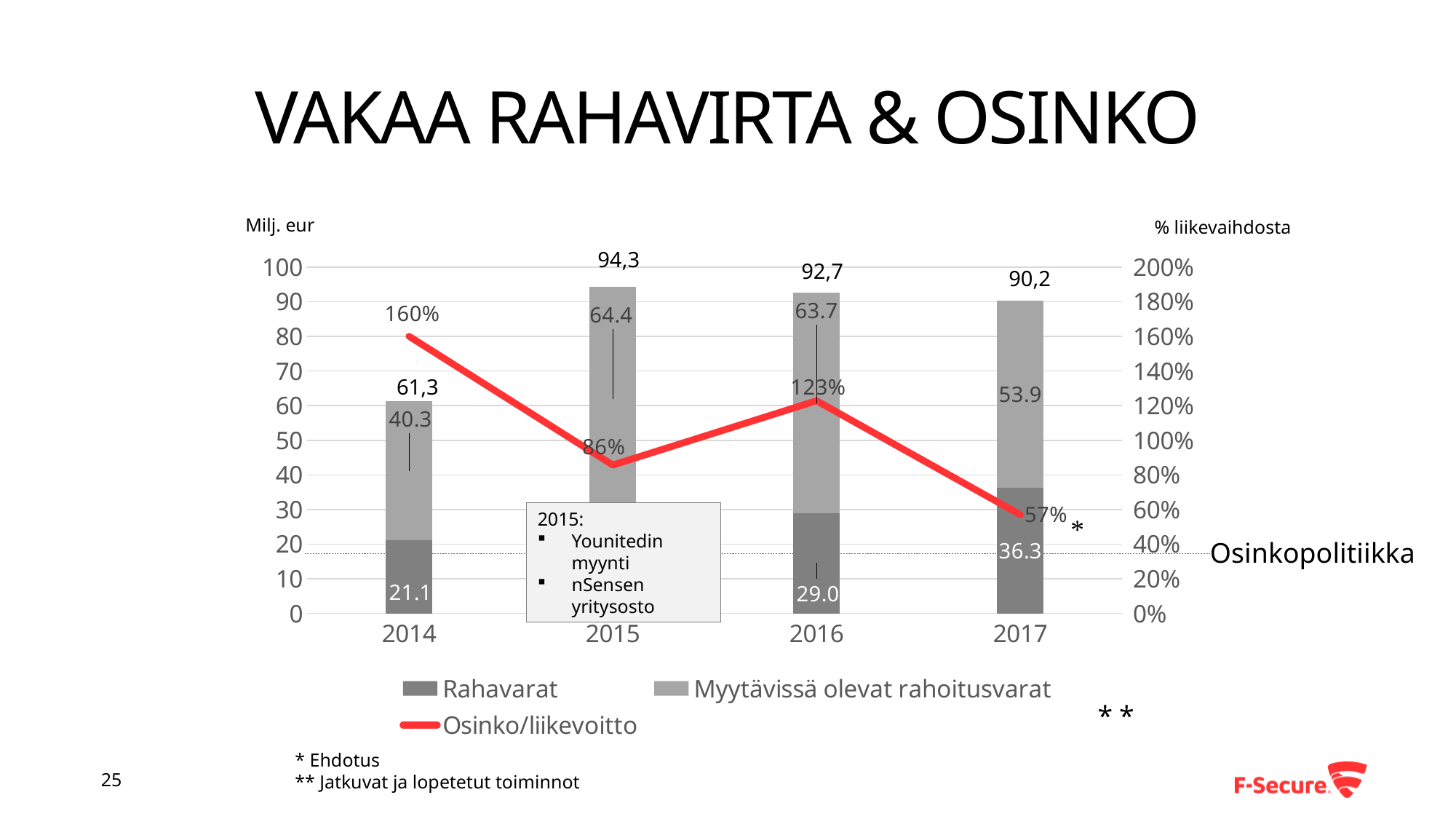
How many series does the legend list? 3 Which year has the lowest stacked bar total? 2014 What is the unit label shown on the left axis? Milj. eur Which is larger, the Rahavarat value for 2016 or for 2014? 2016 What is the Osinko/liikevoitto percentage for 2014? 160% What is the Rahavarat value for 2017? 36.3 Does the Osinko/liikevoitto line rise or fall from 2016 to 2017? fall How many years are shown on the x axis? 4 Which year has the highest Osinko/liikevoitto percentage? 2014 What is the total value shown above the stacked bar for 2015? 94,3 What is the Myytävissä olevat rahoitusvarat value for 2016? 63.7 What is the difference between the Osinko/liikevoitto percentages for 2016 and 2017? 66%